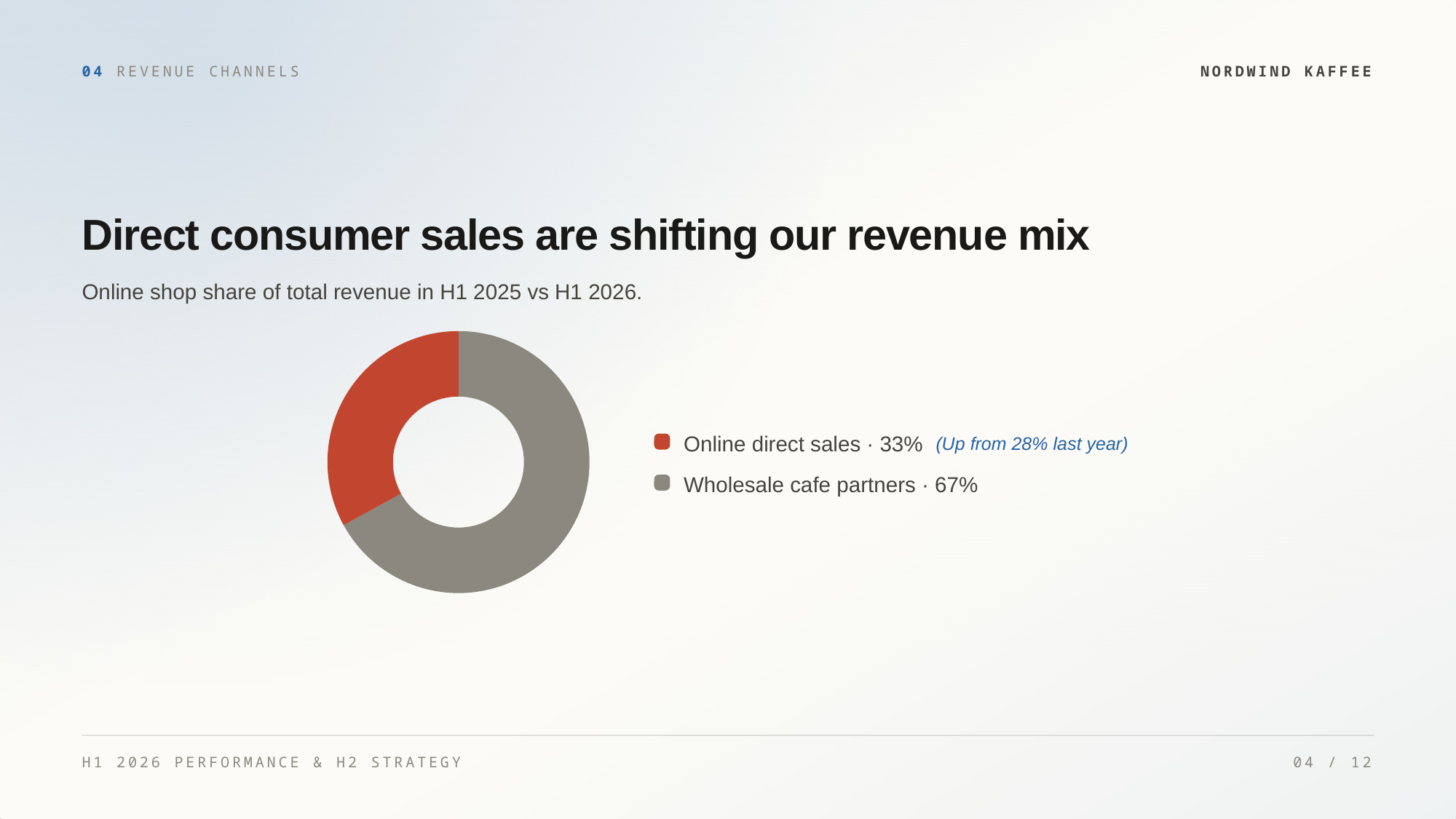
What share of revenue comes from Wholesale cafe partners? 67% What is the difference in percentage points between Wholesale cafe partners and Online direct sales? 34 What colour represents Online direct sales in the chart? Red What share of revenue comes from Online direct sales? 33% By how many percentage points did the Online direct sales share rise from last year to 33%? 5 Which category has the largest share of the pie? Wholesale cafe partners What kind of chart is shown on the slide? Pie chart (donut) How many categories does the chart show? 2 What was the Online direct sales share last year, according to the legend note? 28% Which category has the smallest share of the pie? Online direct sales Which is larger, the share for Online direct sales or the share for Wholesale cafe partners? Wholesale cafe partners What colour represents Wholesale cafe partners in the chart? Grey